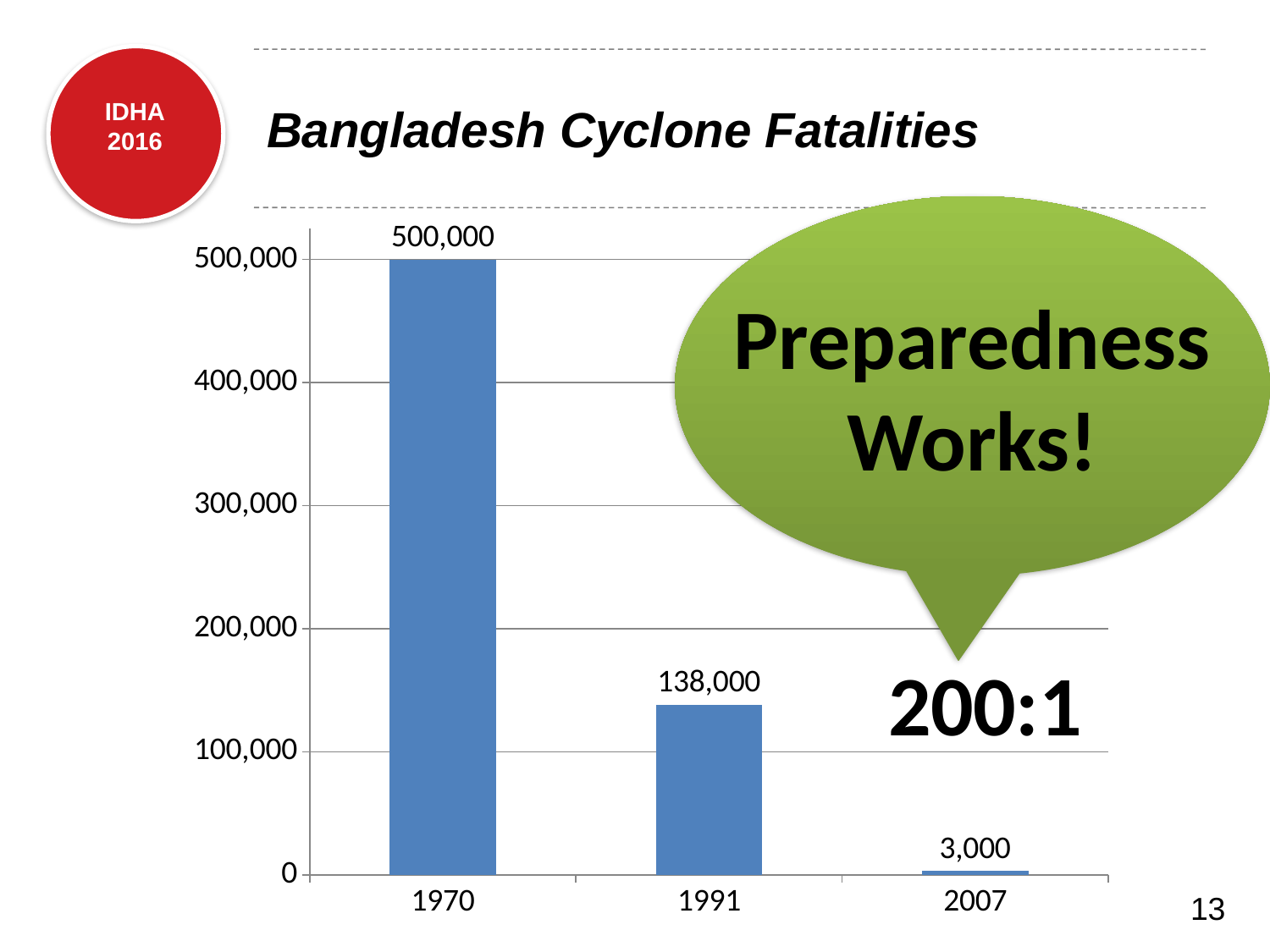
What is the value for 2007? 3,000 Is the value for 1991 greater or less than 200,000? less What kind of chart is shown on the slide? bar chart Which year has the highest number of fatalities? 1970 What is the difference between the values for 1970 and 1991? 362,000 How many years are shown on the x axis? 3 What is the value for 1991? 138,000 What is the difference between the values for 1991 and 2007? 135,000 Do the values rise or fall from 1970 to 2007? fall Which year has the lowest number of fatalities? 2007 What is the value for 1970? 500,000 Which is larger, the value for 1991 or the value for 2007? 1991